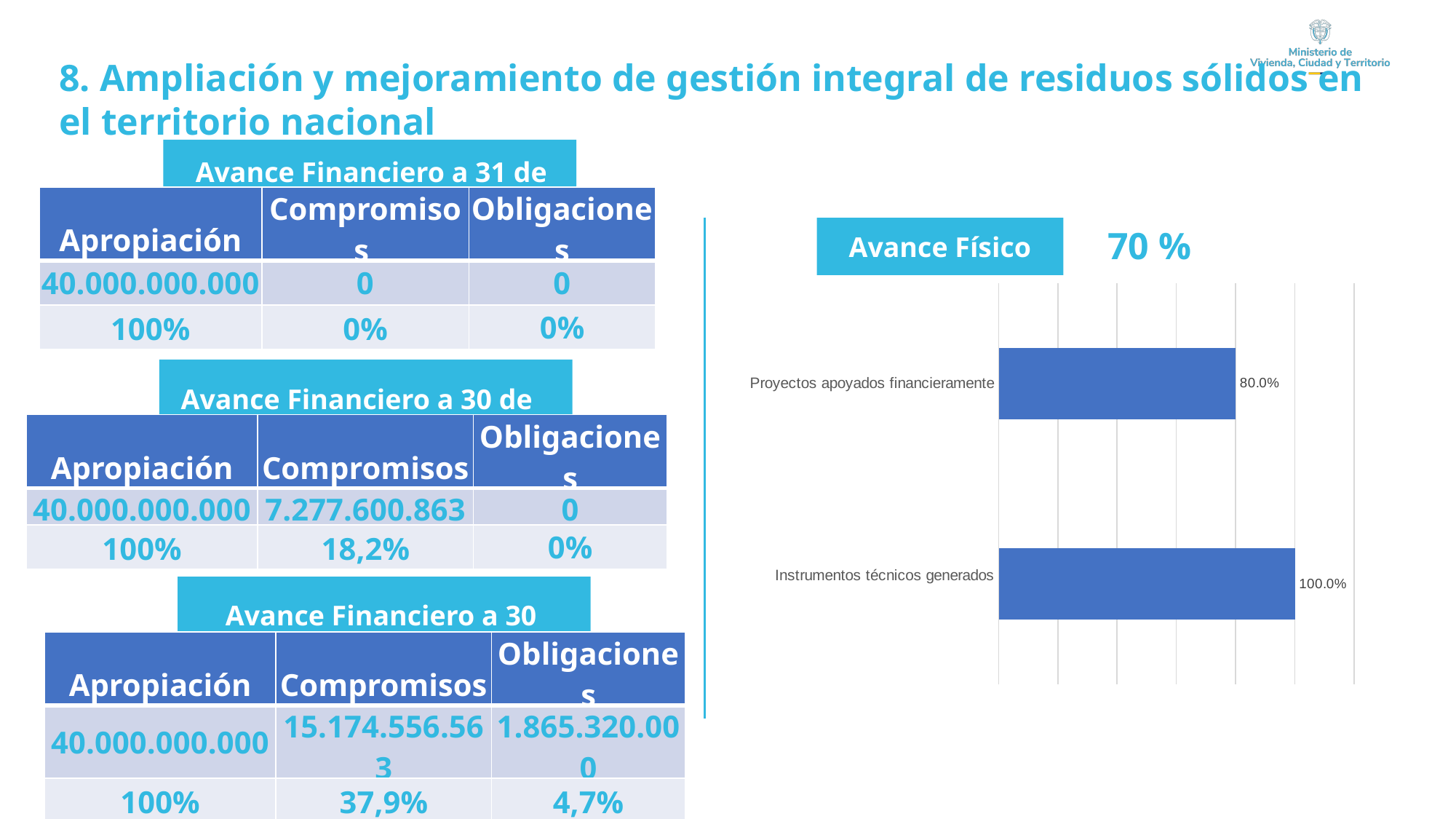
What kind of chart is shown on the right side of the slide? Bar chart Which category in the bar chart has the highest value? Instrumentos técnicos generados In the bar chart, which is larger: Proyectos apoyados financieramente or Instrumentos técnicos generados? Instrumentos técnicos generados How many categories are shown in the bar chart? 2 What is the heading shown above the bar chart? Avance Físico What is the value for Proyectos apoyados financieramente in the bar chart? 80.0% What percentage is displayed next to the Avance Físico heading above the bar chart? 70 % What is the difference between the values for Instrumentos técnicos generados and Proyectos apoyados financieramente in the bar chart? 20.0% Which category in the bar chart has the lowest value? Proyectos apoyados financieramente What is the value for Instrumentos técnicos generados in the bar chart? 100.0%